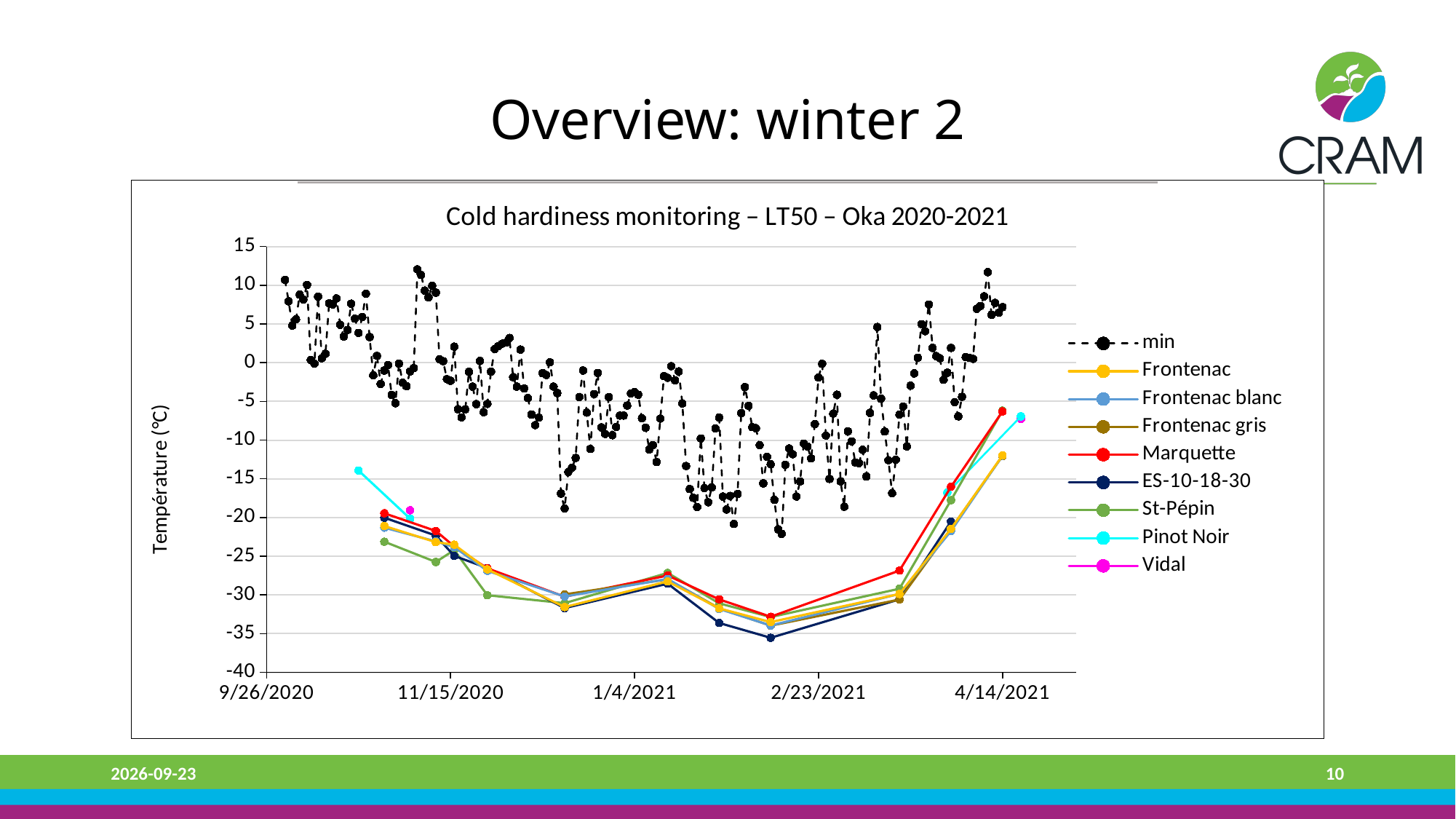
Is the first plotted value of the Pinot Noir series greater or less than -20? greater How do the cultivar LT50 series change from November 2020 to mid-February 2021? they fall Which cultivar series reaches the lowest temperature on the chart? ES-10-18-30 Is the lowest value of the Marquette series greater or less than -30? less What kind of chart is shown on the slide? line chart Is the lowest value of the ES-10-18-30 series greater or less than -30? less What is the label of the y axis? Température (°C) How many series does the legend list? 9 At the last date plotted (around 4/14/2021), which is higher: Marquette or Frontenac? Marquette What is the title of the chart? Cold hardiness monitoring – LT50 – Oka 2020-2021 How many points are plotted for the Pinot Noir series? 4